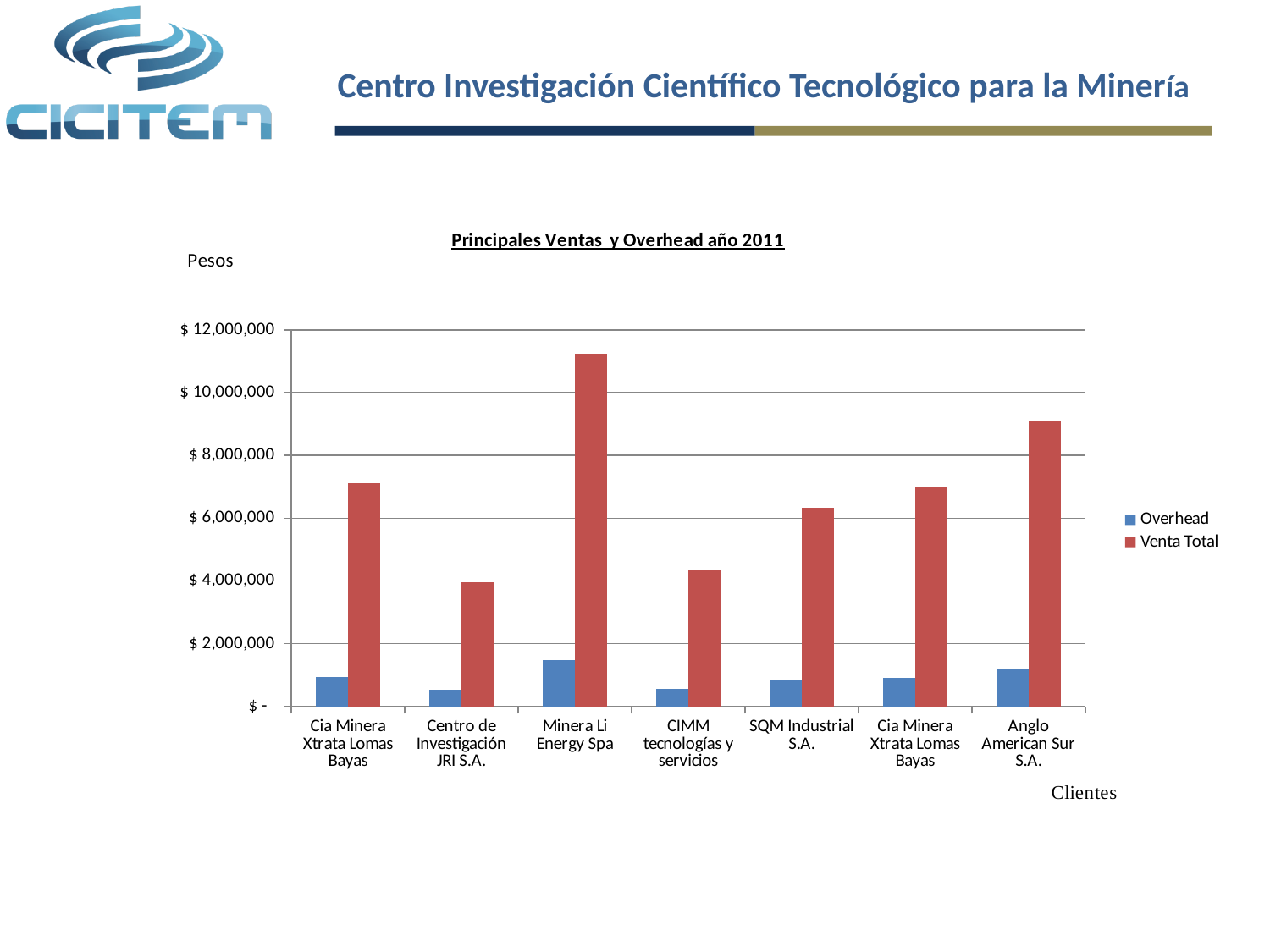
Which client has the highest Overhead? Minera Li Energy Spa What kind of chart is shown on the slide? bar chart Which client has the highest Venta Total? Minera Li Energy Spa How many client categories are shown on the x axis? 7 Is the Overhead for Minera Li Energy Spa greater or less than $ 2,000,000? less What is the title of the chart? Principales Ventas y Overhead año 2011 Which is larger, the Venta Total for Anglo American Sur S.A. or for SQM Industrial S.A.? Anglo American Sur S.A. Is the Venta Total for Anglo American Sur S.A. greater or less than $ 8,000,000? greater Which client has the lowest Venta Total? Centro de Investigación JRI S.A. Is the Venta Total for Minera Li Energy Spa greater or less than $ 10,000,000? greater How many series does the legend list? 2